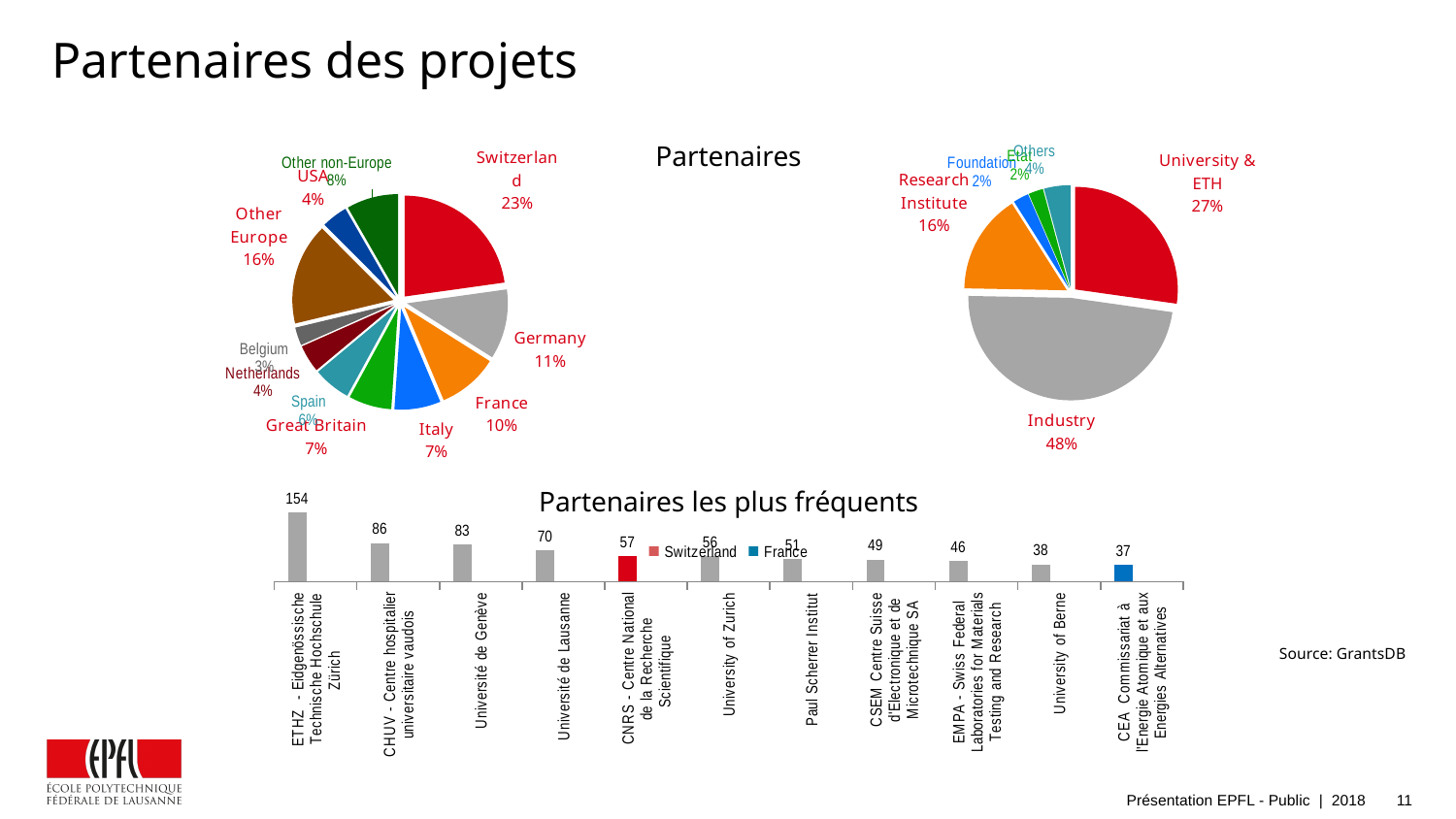
In the bar chart 'Partenaires les plus fréquents', how many series does the legend list? 2 In the bar chart 'Partenaires les plus fréquents', which partner has the highest value? ETHZ - Eidgenössische Technische Hochschule Zürich In the left pie chart, what share does Switzerland have? 23% In the bar chart 'Partenaires les plus fréquents', do the values rise or fall from left to right? fall In the left pie chart, which is larger, Germany or France? Germany In the bar chart 'Partenaires les plus fréquents', what is the value for ETHZ - Eidgenössische Technische Hochschule Zürich? 154 In the right pie chart 'Partenaires', which category has the smallest share among University & ETH, Industry and Research Institute? Research Institute What kind of chart is 'Partenaires les plus fréquents'? bar chart In the bar chart 'Partenaires les plus fréquents', how many partners are shown? 11 In the bar chart 'Partenaires les plus fréquents', which partner has the lowest value? CEA Commissariat à l'Energie Atomique et aux Energies Alternatives In the right pie chart 'Partenaires', what share does Industry have? 48% In the bar chart 'Partenaires les plus fréquents', what is the difference between the values for CHUV and Université de Genève? 3